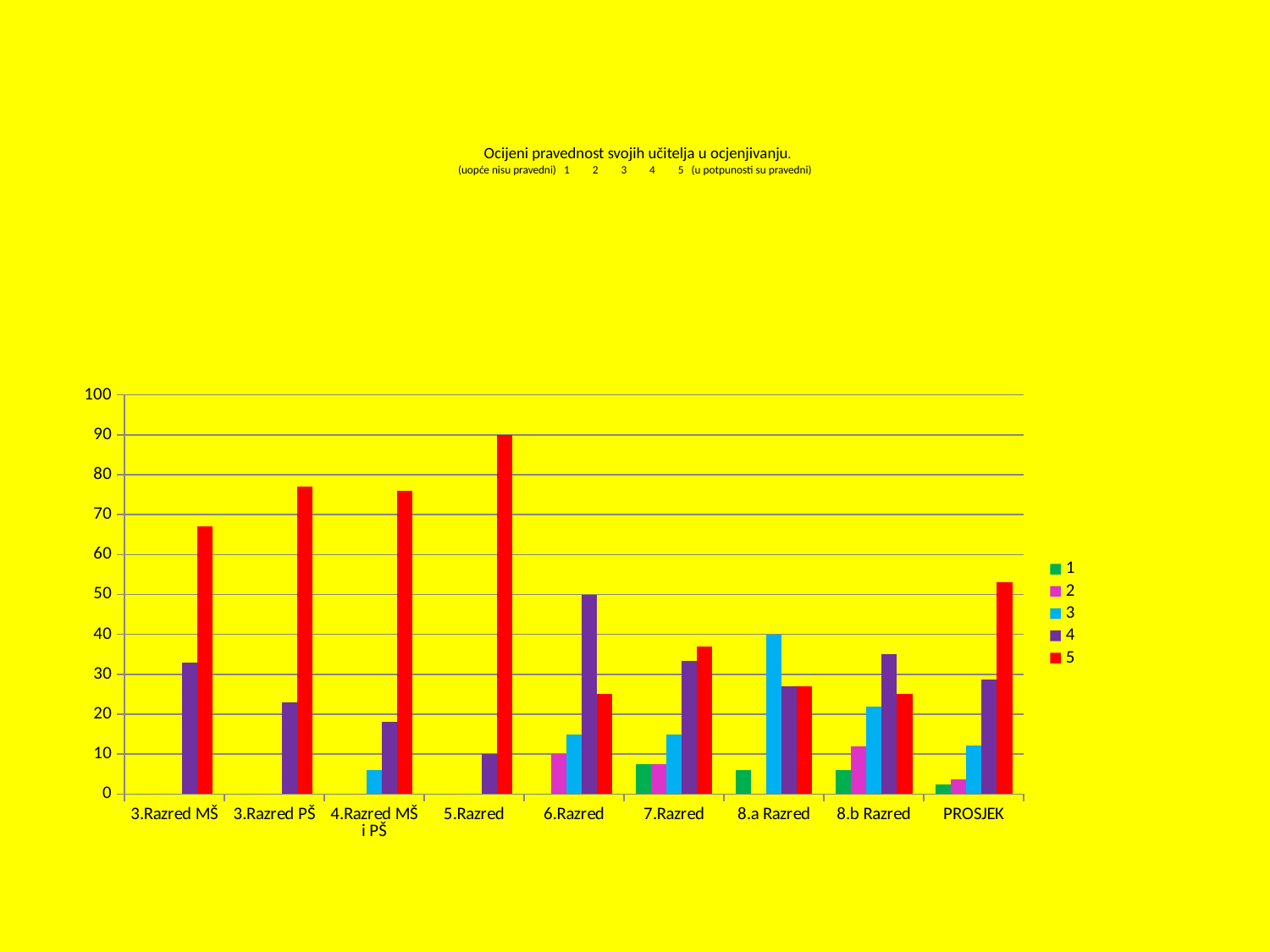
What is the value of series 3 for 8.a Razred? 40 What is the value of series 5 for 5.Razred? 90 Which category has the highest value for series 5? 5.Razred How many series does the legend list? 5 What colour represents series 5 in the legend? red Is the value of series 5 for 3.Razred PŠ greater or less than 70? greater Which is larger: series 4 for 6.Razred or series 4 for 7.Razred? 6.Razred What kind of chart is shown on the slide? bar chart Is the value of series 5 for PROSJEK greater or less than 50? greater How many categories are shown along the x axis? 9 What is the value of series 4 for 6.Razred? 50 Is the value of series 5 for 3.Razred MŠ greater or less than 70? less